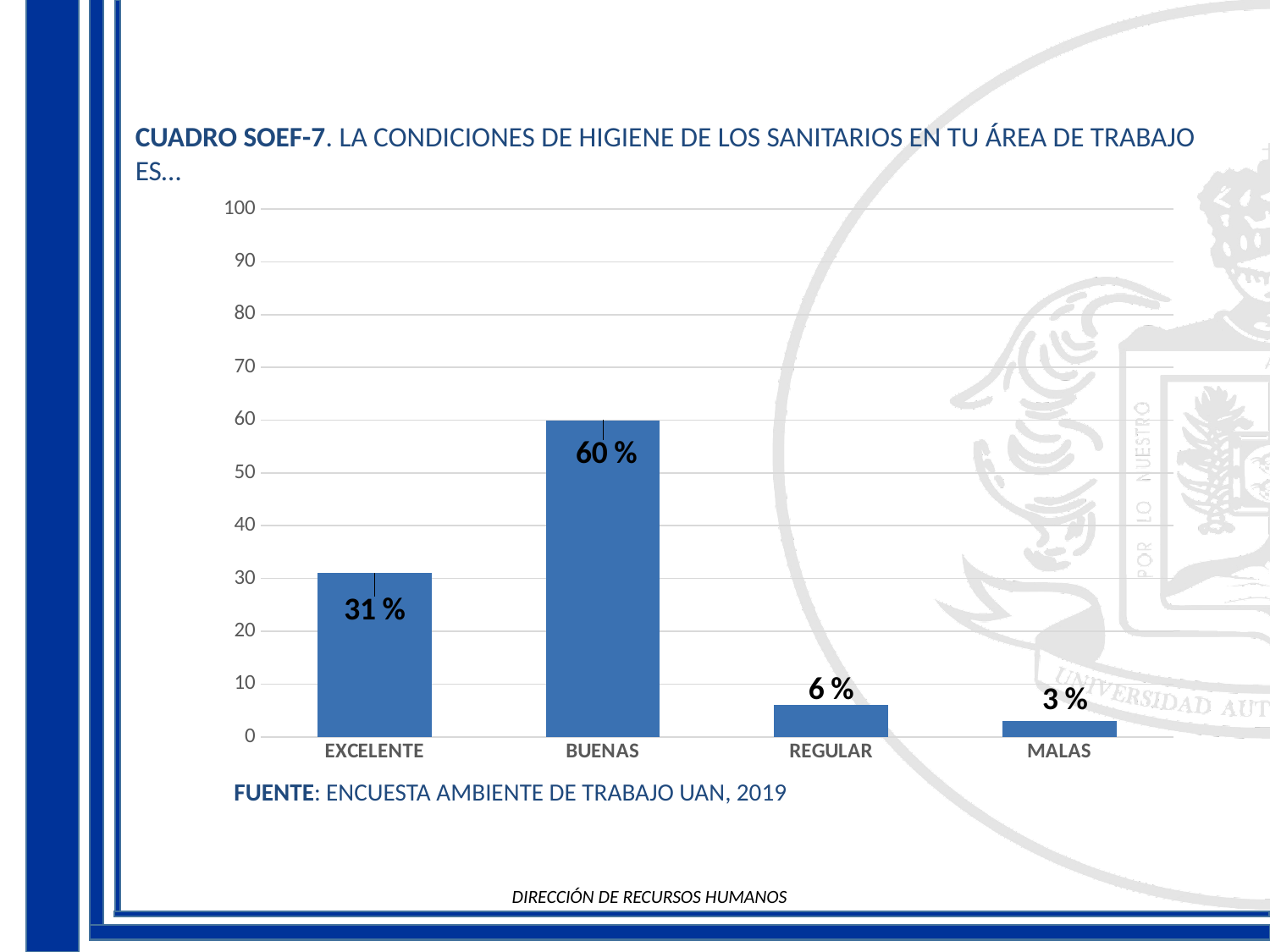
Is the value for EXCELENTE greater or less than 40? less What is the value for REGULAR? 6 % Which category has the lowest value? MALAS Which is larger, the value for REGULAR or the value for MALAS? REGULAR What is the value for EXCELENTE? 31 % What is the difference between the values for BUENAS and EXCELENTE? 29 % What kind of chart is shown on the slide? bar chart What source is cited below the chart? ENCUESTA AMBIENTE DE TRABAJO UAN, 2019 What is the value for MALAS? 3 % What is the value for BUENAS? 60 % How many categories are shown on the x axis? 4 Which category has the highest value? BUENAS